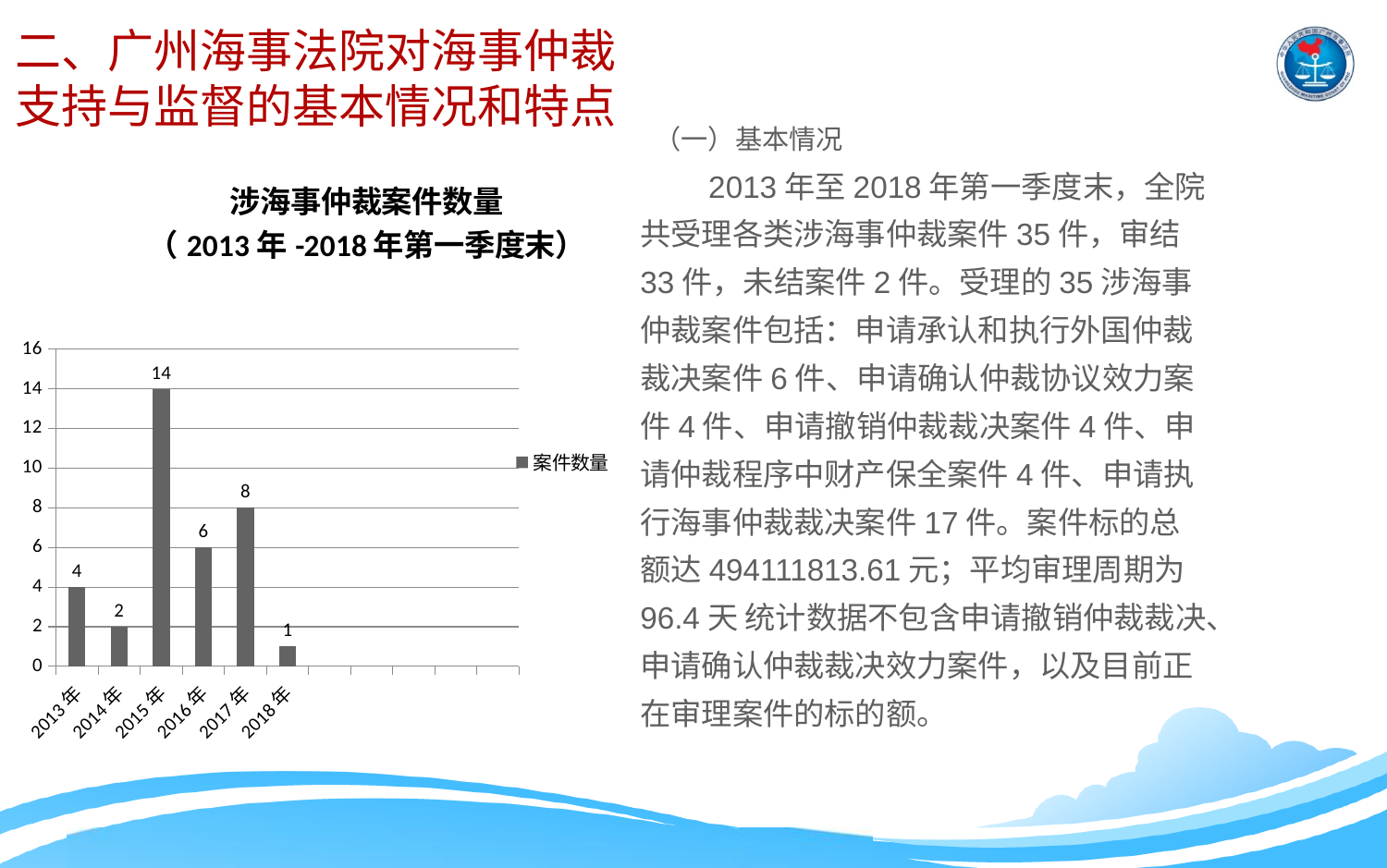
Which year has the lowest number of cases? 2018年 How many years are shown on the x axis of the chart? 6 What kind of chart is shown on the slide? bar chart What is the value for 2013年 in the chart? 4 What is the difference between the values for 2015年 and 2017年? 6 Which year has the highest number of cases? 2015年 What is the value for 2015年 in the chart? 14 What is the legend entry of the chart? 案件数量 How many series does the legend list? 1 What is the value for 2018年 in the chart? 1 Is the value for 2017年 greater or less than 10? less Which is larger, the value for 2016年 or the value for 2014年? 2016年